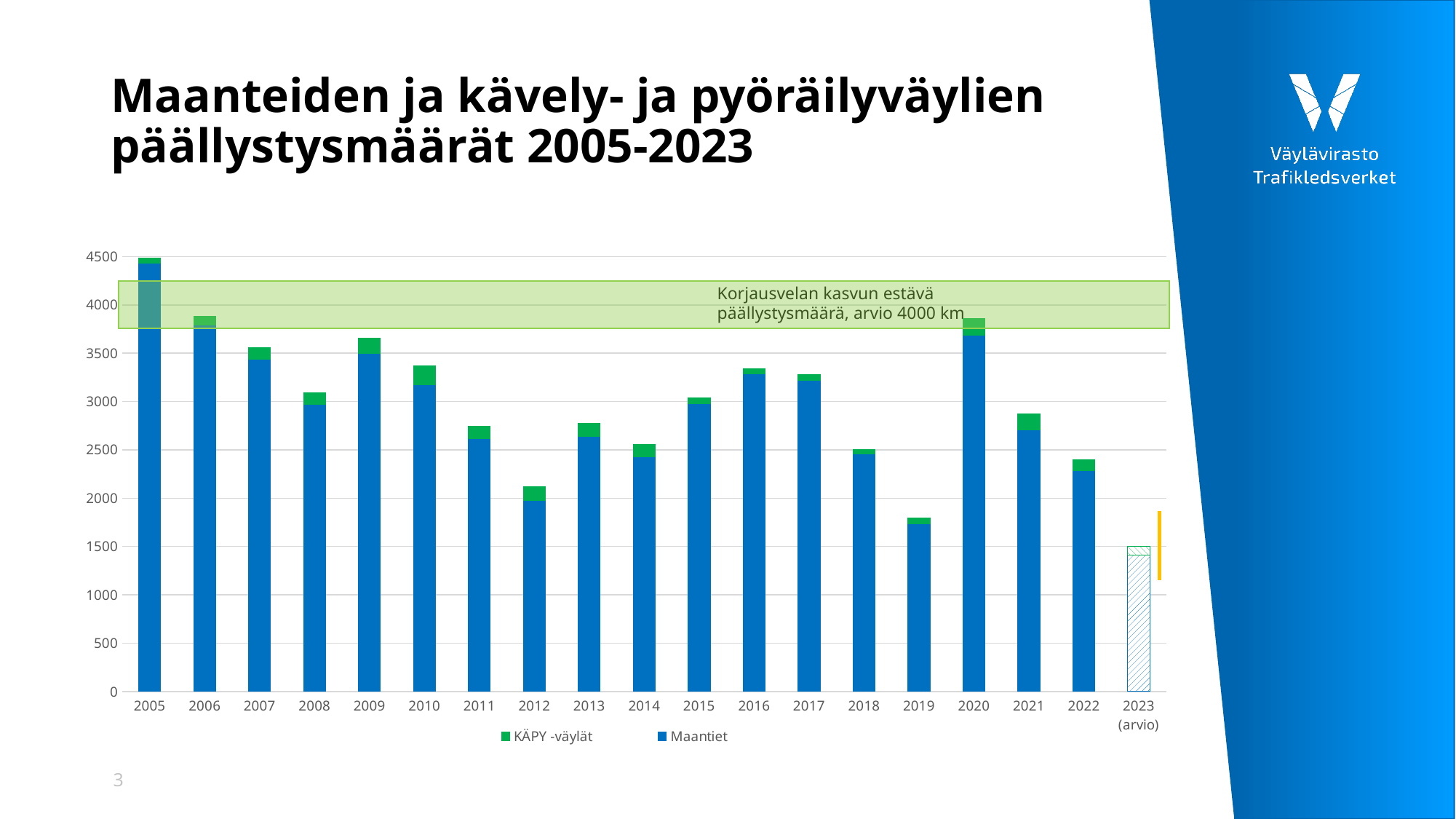
How many series does the legend list? 2 Which year has the lowest total bar? 2023 (arvio) Which year has the larger total bar, 2009 or 2014? 2009 How many years (categories) are shown on the x axis? 19 Is the Maantiet value for 2019 greater or less than 2000? less What kind of chart is shown on the slide? stacked bar chart Is the total value for 2012 greater or less than 2500? less Is the total value for 2020 greater or less than 3500? greater Which two series are listed in the legend? KÄPY -väylät and Maantiet Which year has the highest total bar? 2005 Which year has the larger total bar, 2016 or 2018? 2016 What estimated paving amount does the green band annotation give as preventing the growth of the repair backlog? arvio 4000 km